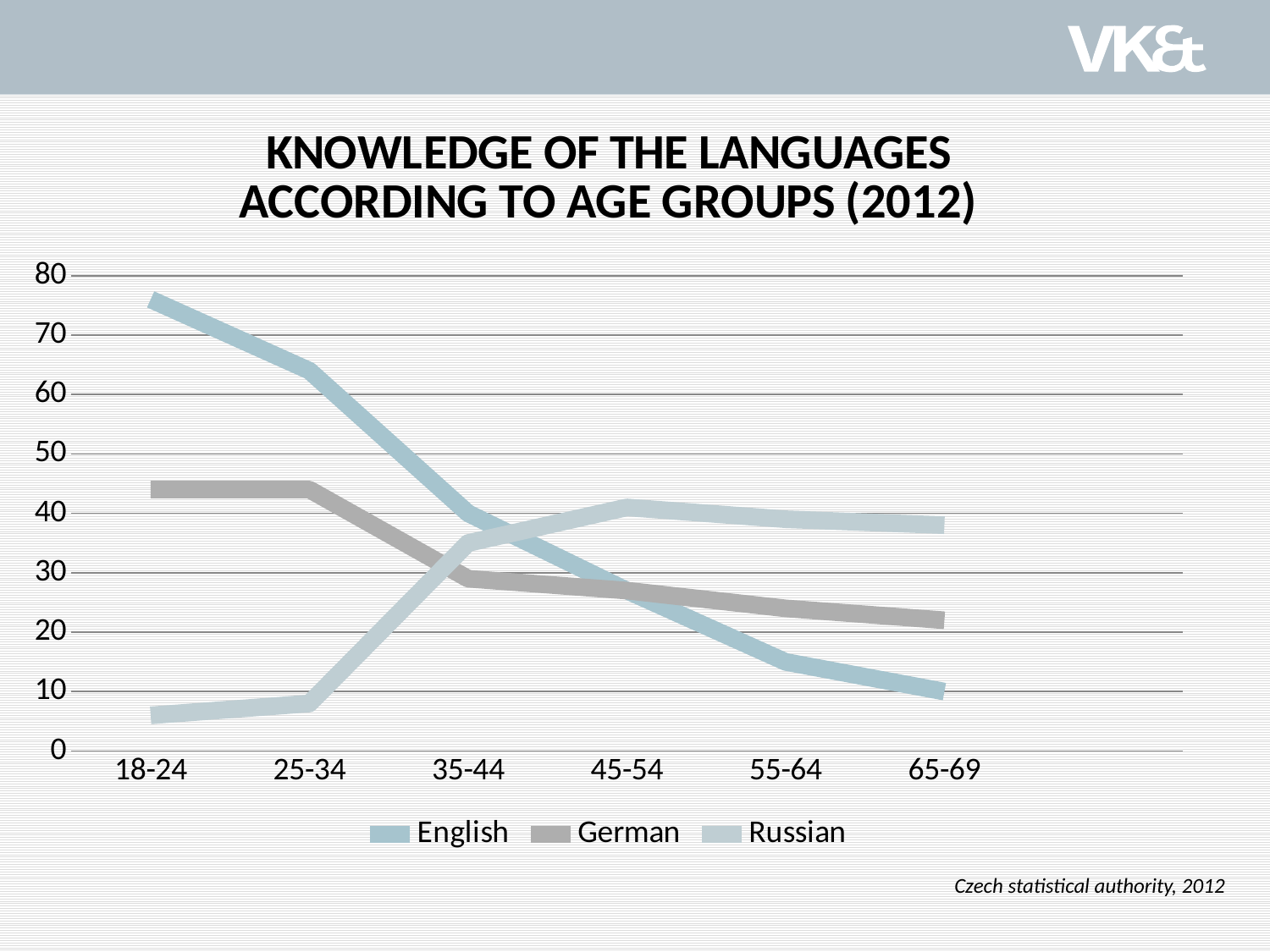
Is the value for German in the 65-69 age group greater or less than 30? less What is the title of the chart? KNOWLEDGE OF THE LANGUAGES ACCORDING TO AGE GROUPS (2012) Is the value for English in the 65-69 age group greater or less than 20? less Which age group has the highest value for English? 18-24 How many series does the legend list? 3 Is the value for English in the 18-24 age group greater or less than 70? greater In the 65-69 age group, which is larger: English or Russian? Russian How many age groups are shown on the x axis? 6 What kind of chart is shown on the slide? line chart Does the value for English rise or fall across the age groups from 18-24 to 65-69? fall Which age group has the lowest value for Russian? 18-24